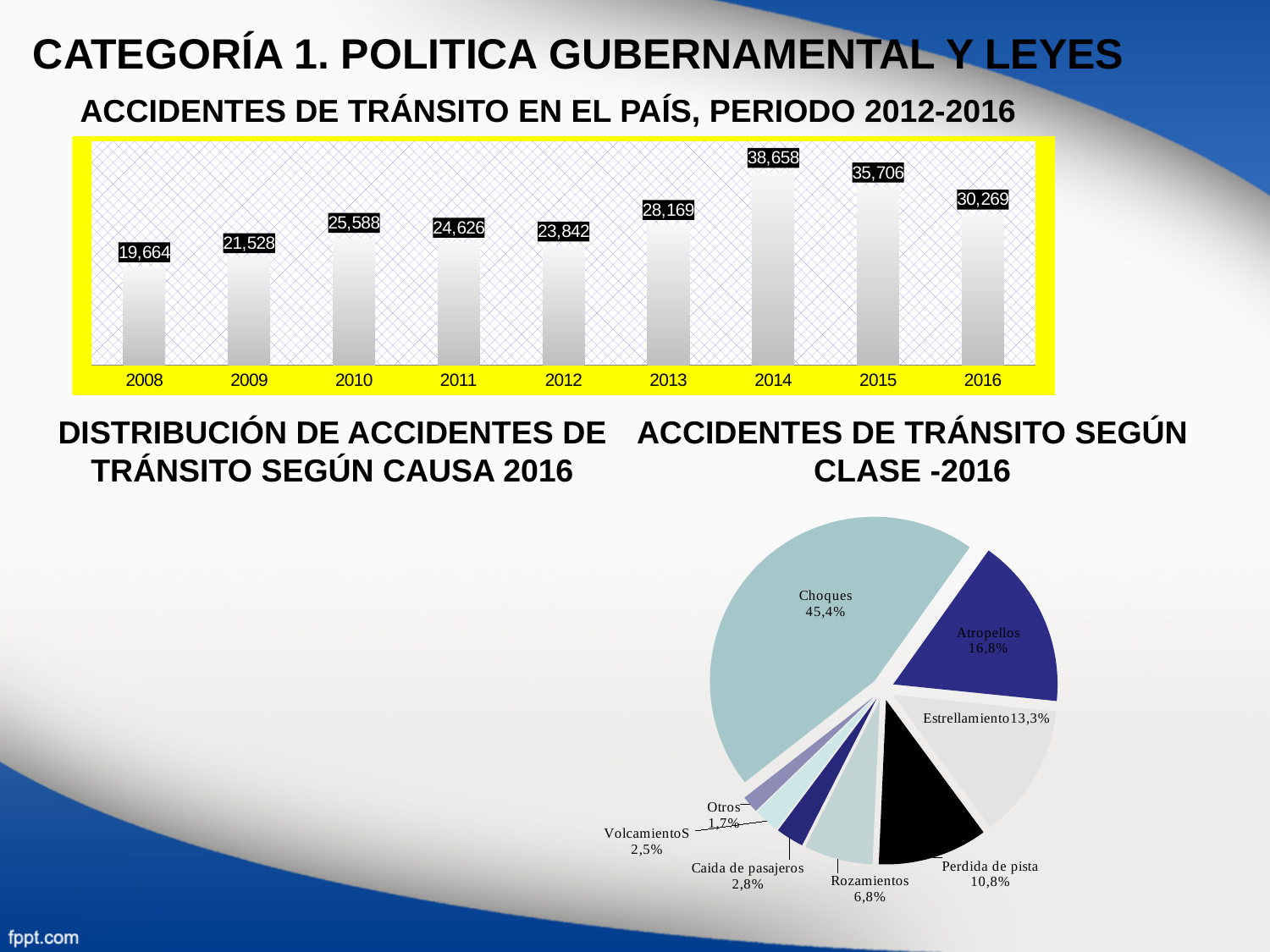
How many years are shown in the bar chart 'ACCIDENTES DE TRÁNSITO EN EL PAÍS, PERIODO 2012-2016'? 9 In the pie chart 'ACCIDENTES DE TRÁNSITO SEGÚN CLASE -2016', what share does Choques have? 45,4% In the bar chart 'ACCIDENTES DE TRÁNSITO EN EL PAÍS, PERIODO 2012-2016', what is the difference between the values for 2015 and 2016? 5,437 How many slices does the pie chart 'ACCIDENTES DE TRÁNSITO SEGÚN CLASE -2016' have? 8 In the bar chart 'ACCIDENTES DE TRÁNSITO EN EL PAÍS, PERIODO 2012-2016', what is the value for 2008? 19,664 In the pie chart 'ACCIDENTES DE TRÁNSITO SEGÚN CLASE -2016', which class has the smallest share? Otros In the bar chart 'ACCIDENTES DE TRÁNSITO EN EL PAÍS, PERIODO 2012-2016', do the values rise or fall from 2014 to 2016? Fall In the bar chart 'ACCIDENTES DE TRÁNSITO EN EL PAÍS, PERIODO 2012-2016', which year has the highest value? 2014 In the bar chart 'ACCIDENTES DE TRÁNSITO EN EL PAÍS, PERIODO 2012-2016', which year has the lowest value? 2008 What kind of chart is 'ACCIDENTES DE TRÁNSITO EN EL PAÍS, PERIODO 2012-2016'? Bar chart In the bar chart 'ACCIDENTES DE TRÁNSITO EN EL PAÍS, PERIODO 2012-2016', what is the value for 2014? 38,658 In the bar chart 'ACCIDENTES DE TRÁNSITO EN EL PAÍS, PERIODO 2012-2016', which is larger, the value for 2011 or the value for 2012? 2011